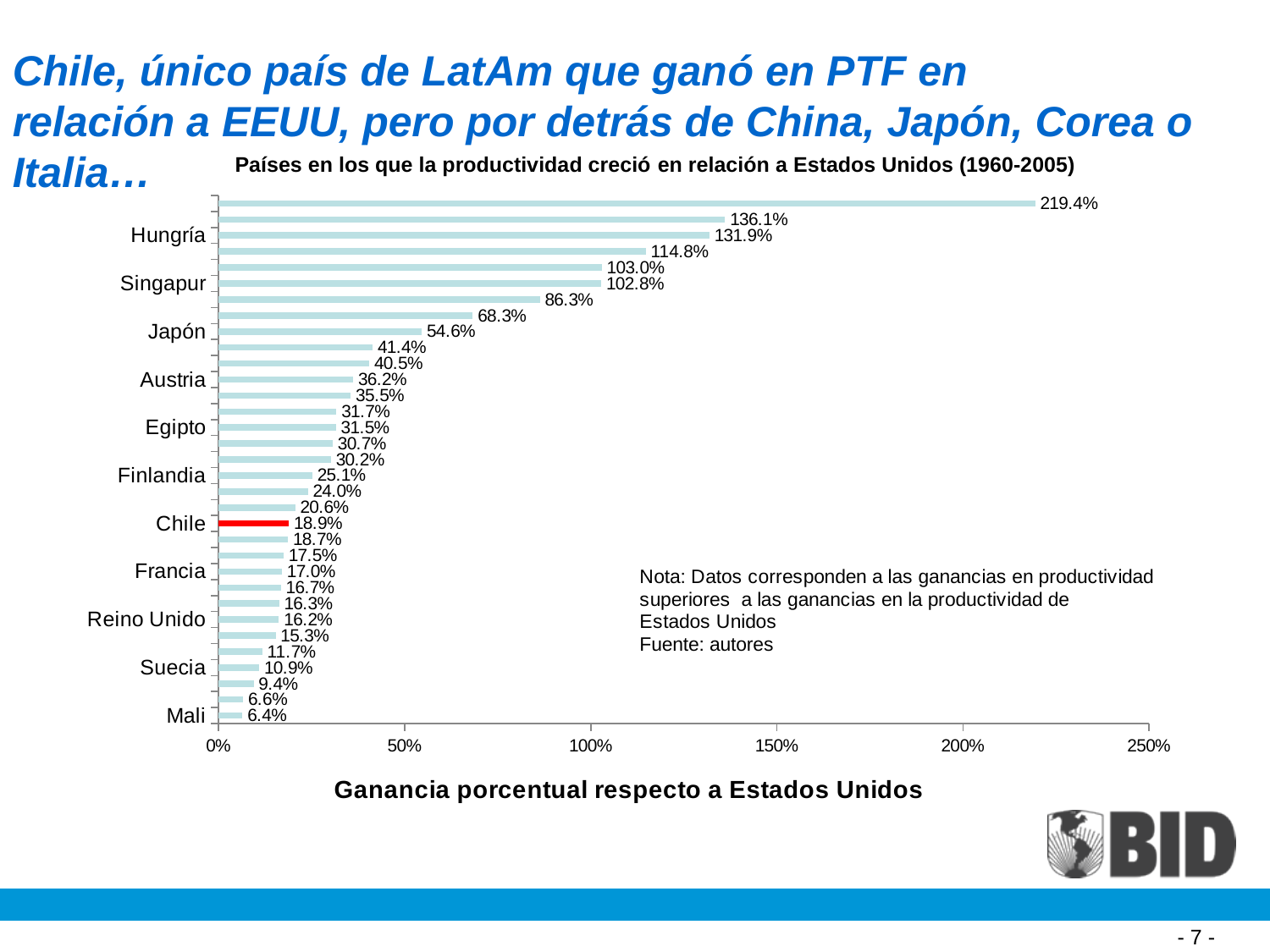
What is the value for Singapur? 102.8% What type of chart is shown on the slide? bar chart What is the value for Japón? 54.6% Which country's bar is highlighted in red? Chile What is the value for Chile? 18.9% What is the highest value shown on the chart? 219.4% Which is larger, the value for Austria or the value for Egipto? Austria Is the value for Finlandia greater or less than 50%? less What is the value for Hungría? 131.9% What is the difference between the values for Hungría and Chile? 113.0% Which labelled country has the lowest value? Mali What is the value for Mali? 6.4%